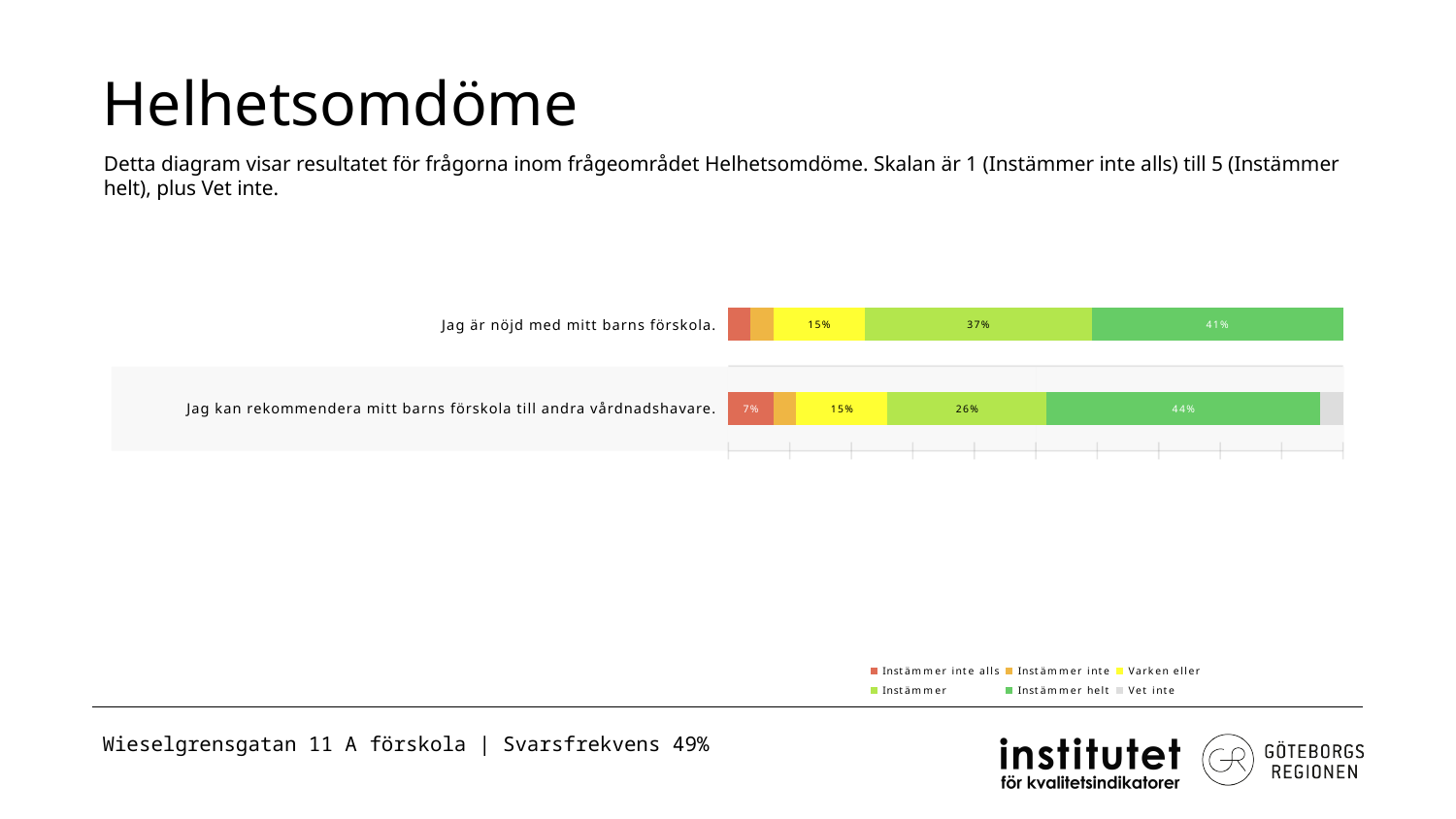
What is the 'Instämmer helt' value for 'Jag kan rekommendera mitt barns förskola till andra vårdnadshavare'? 44% Which statement has the higher 'Instämmer helt' value? Jag kan rekommendera mitt barns förskola till andra vårdnadshavare What is the 'Instämmer' value for 'Jag är nöjd med mitt barns förskola'? 37% How many categories (statements) does the chart show? 2 How many series does the legend list? 6 What is the 'Instämmer helt' value for 'Jag är nöjd med mitt barns förskola'? 41% What is the 'Instämmer inte alls' value for 'Jag kan rekommendera mitt barns förskola till andra vårdnadshavare'? 7% What kind of chart is shown on the slide? stacked bar chart Which statement has the higher 'Instämmer' value? Jag är nöjd med mitt barns förskola What is the difference between the 'Instämmer' values of the two statements? 11% What is the 'Varken eller' value for 'Jag kan rekommendera mitt barns förskola till andra vårdnadshavare'? 15% Which legend entry is shown in grey? Vet inte